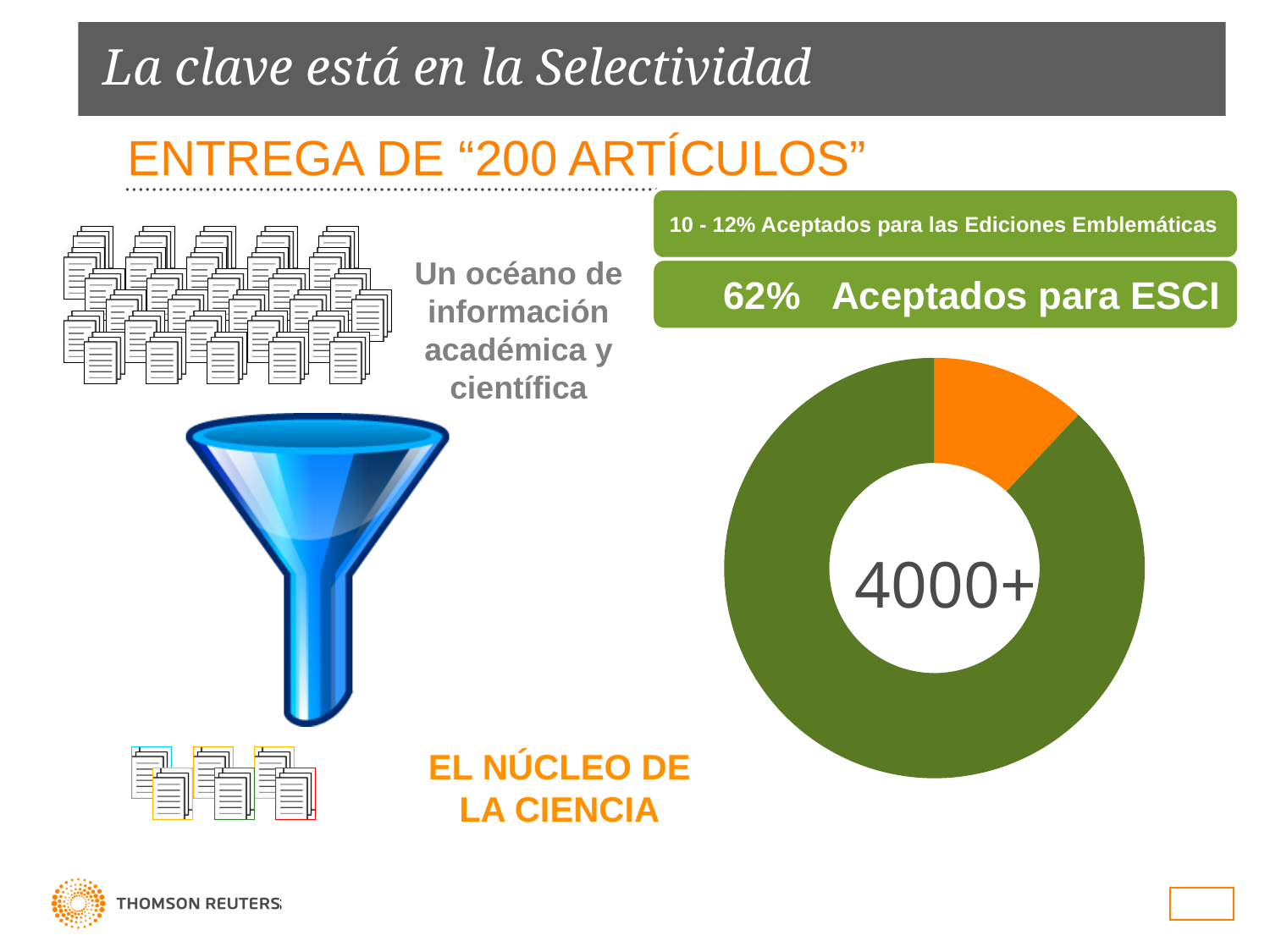
Which colour slice takes up the largest share of the donut chart? Green What kind of chart is shown on the right side of the slide? Donut chart What text is printed in the centre of the donut chart? 4000+ What two colours are used for the slices of the donut chart? Green and orange How many slices does the donut chart on the right have? 2 Which slice of the donut chart is larger, the green one or the orange one? The green one Which colour slice takes up the smallest share of the donut chart? Orange